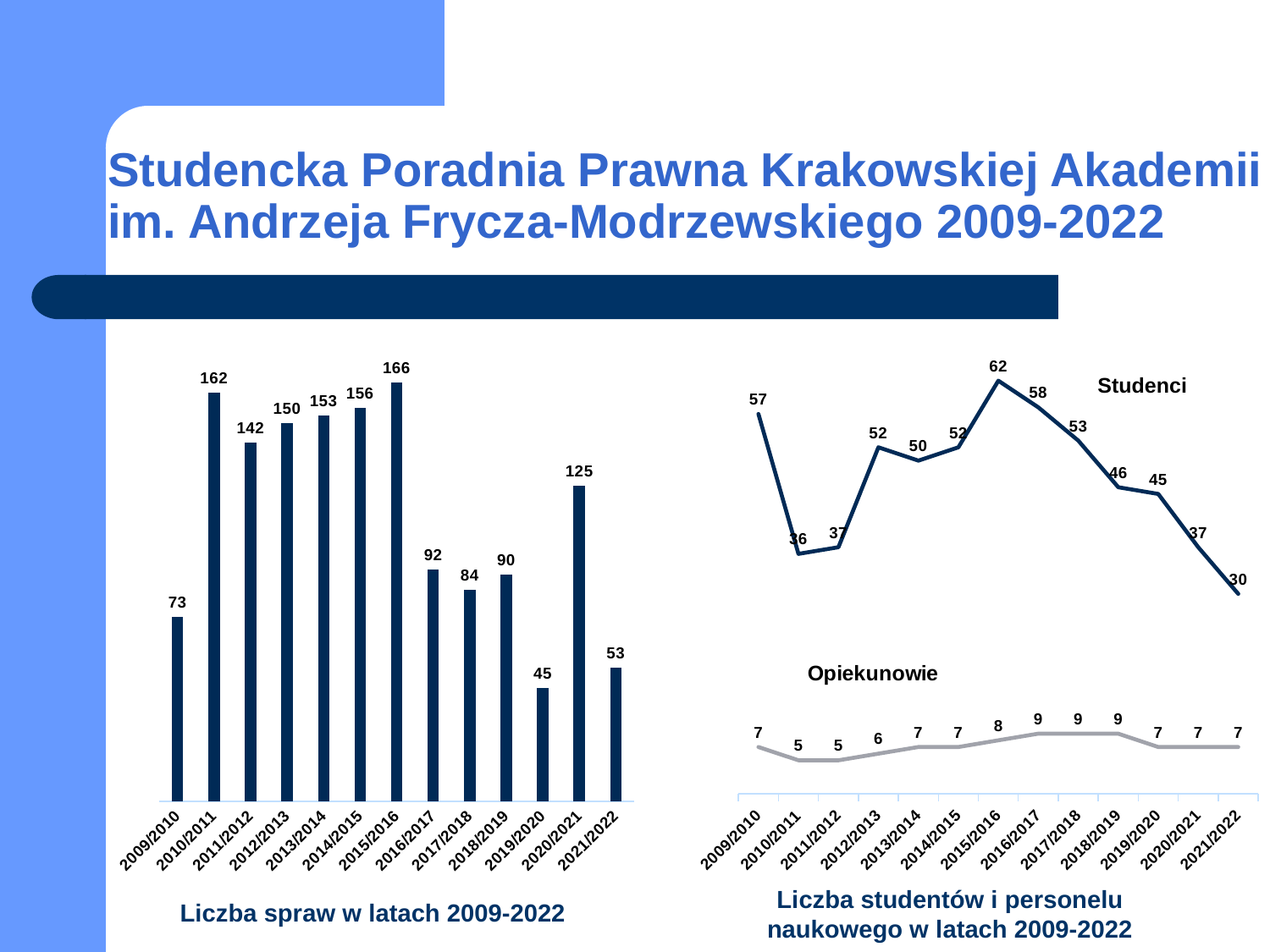
In the chart 'Liczba studentów i personelu naukowego w latach 2009-2022', what is the Studenci value for 2015/2016? 62 What kind of chart is 'Liczba studentów i personelu naukowego w latach 2009-2022'? line chart In the chart 'Liczba spraw w latach 2009-2022', which year has the highest value? 2015/2016 In the chart 'Liczba spraw w latach 2009-2022', what is the value for 2010/2011? 162 In the chart 'Liczba spraw w latach 2009-2022', what is the difference between the values for 2020/2021 and 2021/2022? 72 In the chart 'Liczba studentów i personelu naukowego w latach 2009-2022', what is the Opiekunowie value for 2017/2018? 9 In the chart 'Liczba spraw w latach 2009-2022', how many years are shown on the x axis? 13 In the chart 'Liczba studentów i personelu naukowego w latach 2009-2022', which year has the lowest Studenci value? 2021/2022 In the chart 'Liczba studentów i personelu naukowego w latach 2009-2022', do the Studenci values rise or fall from 2015/2016 to 2021/2022? fall In the chart 'Liczba spraw w latach 2009-2022', which year has the lowest value? 2019/2020 What kind of chart is 'Liczba spraw w latach 2009-2022'? bar chart In the chart 'Liczba studentów i personelu naukowego w latach 2009-2022', is the Studenci value for 2009/2010 larger or smaller than the value for 2010/2011? larger